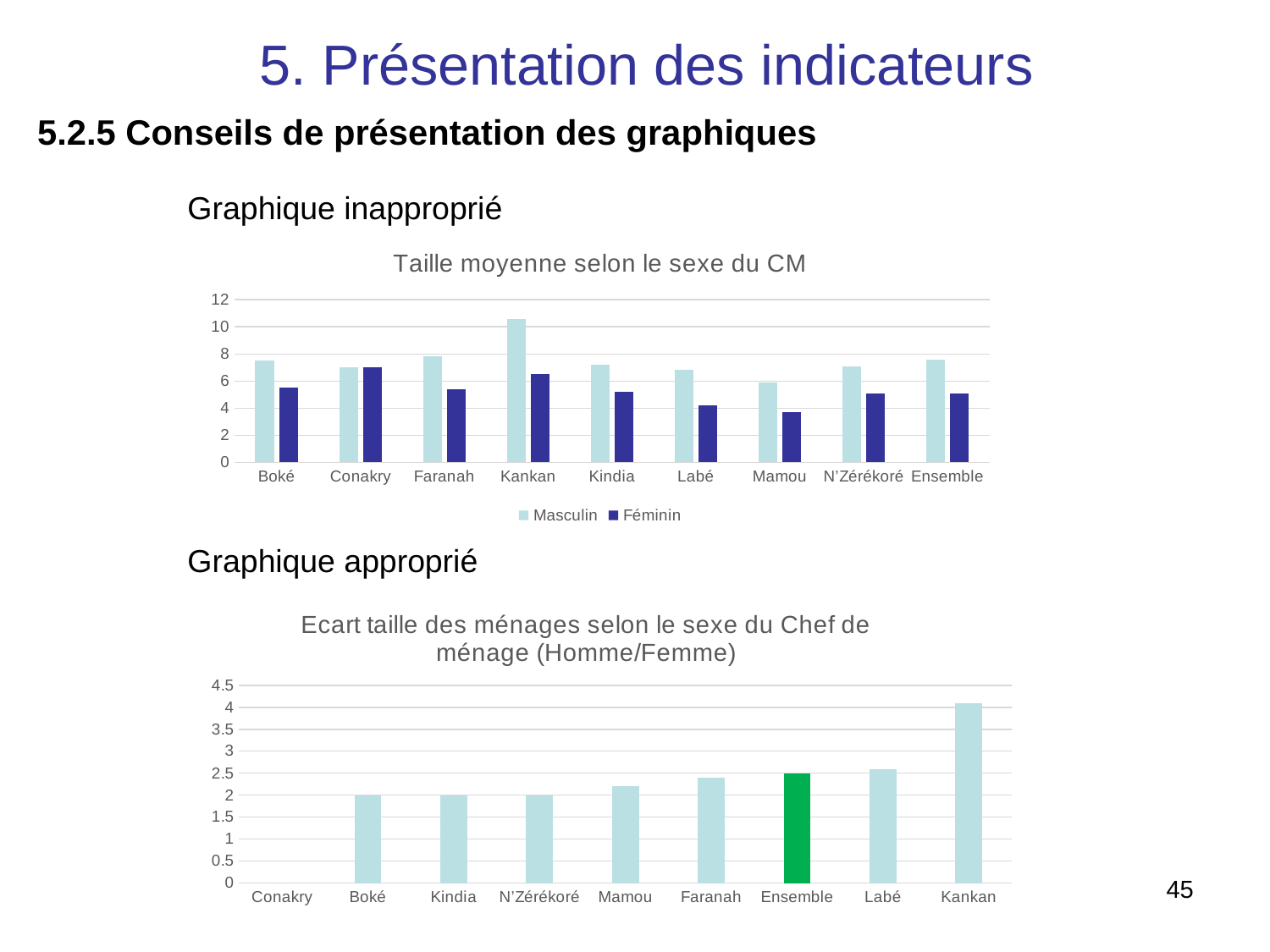
In the bottom chart "Ecart taille des ménages selon le sexe du Chef de ménage (Homme/Femme)", which category has the highest value? Kankan What kind of chart is the top chart titled "Taille moyenne selon le sexe du CM"? bar chart In the bottom chart "Ecart taille des ménages selon le sexe du Chef de ménage (Homme/Femme)", which category's bar is coloured green? Ensemble In the top chart "Taille moyenne selon le sexe du CM", how many categories are shown on the x axis? 9 In the top chart "Taille moyenne selon le sexe du CM", is the Féminin value for Mamou greater or less than 4? less In the bottom chart "Ecart taille des ménages selon le sexe du Chef de ménage (Homme/Femme)", do the values rise or fall from left to right along the x axis? rise In the top chart "Taille moyenne selon le sexe du CM", which category has the highest Masculin value? Kankan In the top chart "Taille moyenne selon le sexe du CM", which category has the lowest Féminin value? Mamou In the bottom chart "Ecart taille des ménages selon le sexe du Chef de ménage (Homme/Femme)", which category has the lowest value? Conakry In the bottom chart "Ecart taille des ménages selon le sexe du Chef de ménage (Homme/Femme)", what is the value for Boké? 2 In the top chart "Taille moyenne selon le sexe du CM", how many series does the legend list? 2 In the top chart "Taille moyenne selon le sexe du CM", is the Masculin value for Kankan greater or less than 10? greater